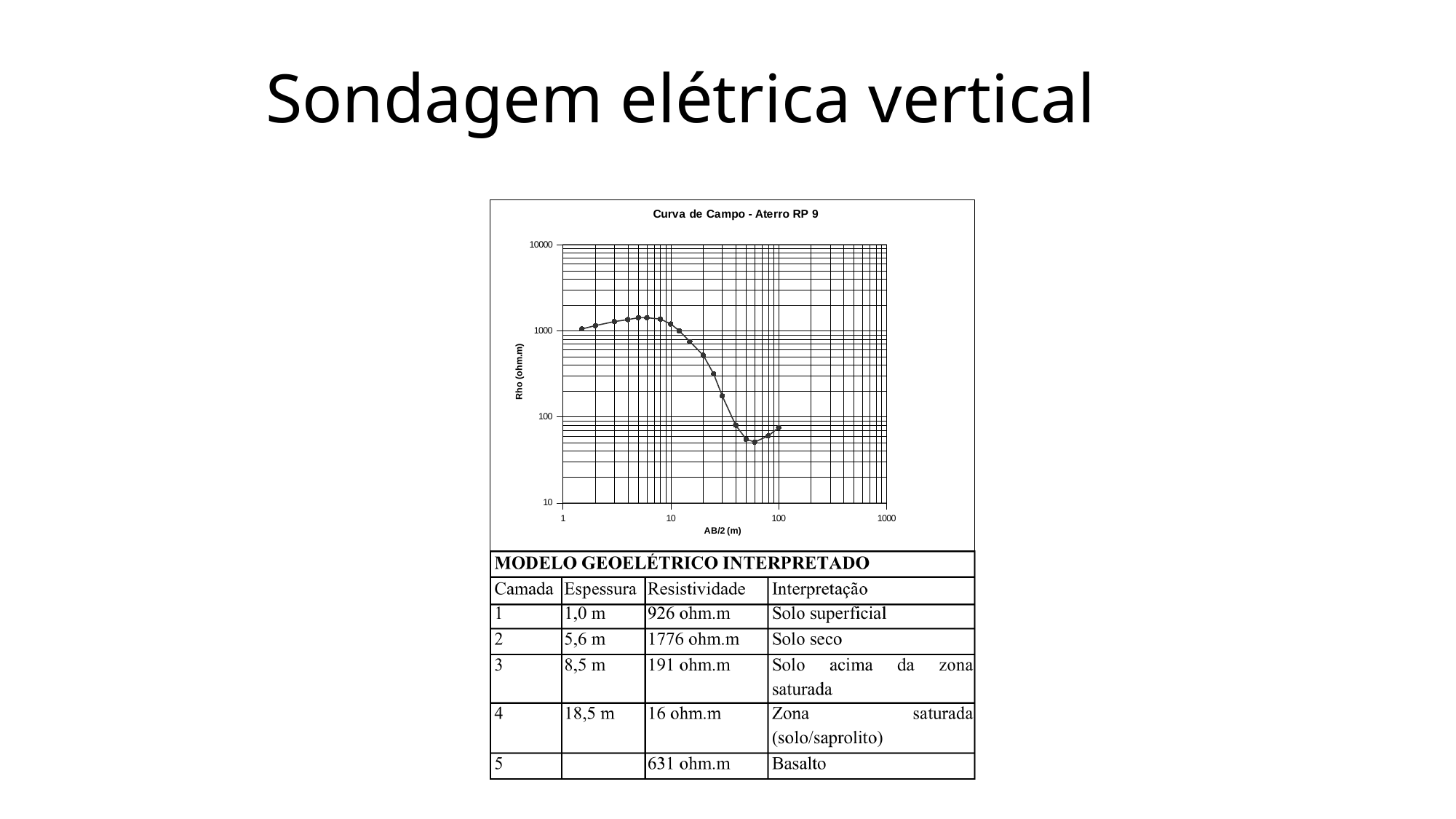
Between AB/2 = 10 m and AB/2 = 50 m, do the values rise or fall? fall Is the value for AB/2 = 10 m greater or less than 1000? greater What is the title of the chart on the slide? Curva de Campo - Aterro RP 9 Is the highest value on the curve greater or less than 1000? greater Which is larger, the value at AB/2 = 10 m or the value at AB/2 = 100 m? AB/2 = 10 m Is the value for AB/2 = 20 m greater or less than 1000? less What kind of chart is shown on the slide? line chart What is the label of the vertical axis of the chart? Rho (ohm.m)